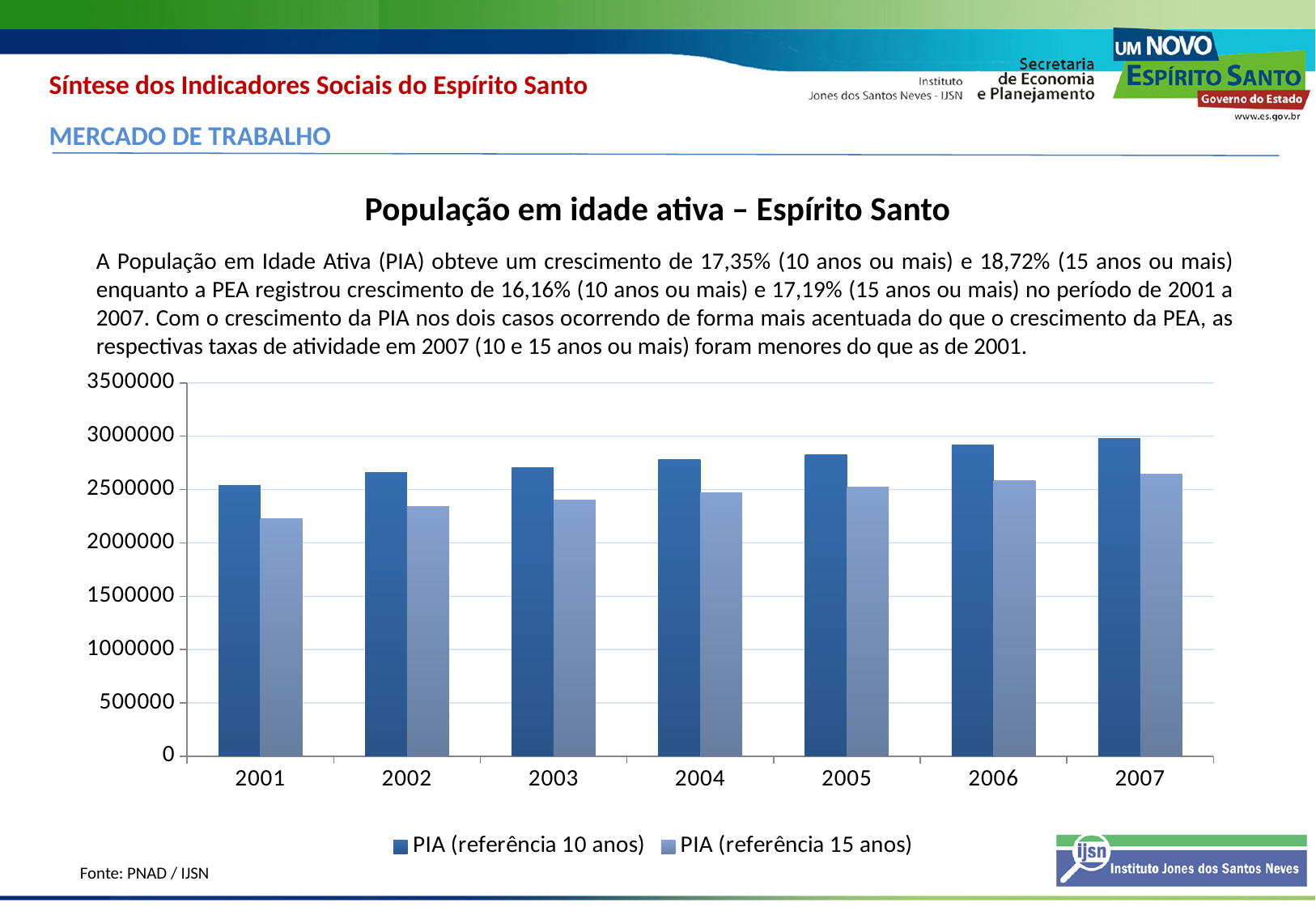
Is the value for PIA (referência 15 anos) in 2001 greater or less than 2500000? less How many years are shown on the x axis of the chart? 7 In 2001, which is larger: PIA (referência 10 anos) or PIA (referência 15 anos)? PIA (referência 10 anos) Is the value for PIA (referência 15 anos) in 2007 greater or less than 2500000? greater Is the value for PIA (referência 10 anos) in 2006 greater or less than 2500000? greater In which year is the value for PIA (referência 15 anos) lowest? 2001 In which year is the value for PIA (referência 10 anos) highest? 2007 What is the title of the chart? População em idade ativa – Espírito Santo What source is cited below the chart? Fonte: PNAD / IJSN How many series does the chart legend list? 2 What kind of chart is shown on the slide? Bar chart Do the values for PIA (referência 10 anos) rise or fall from 2001 to 2007? Rise